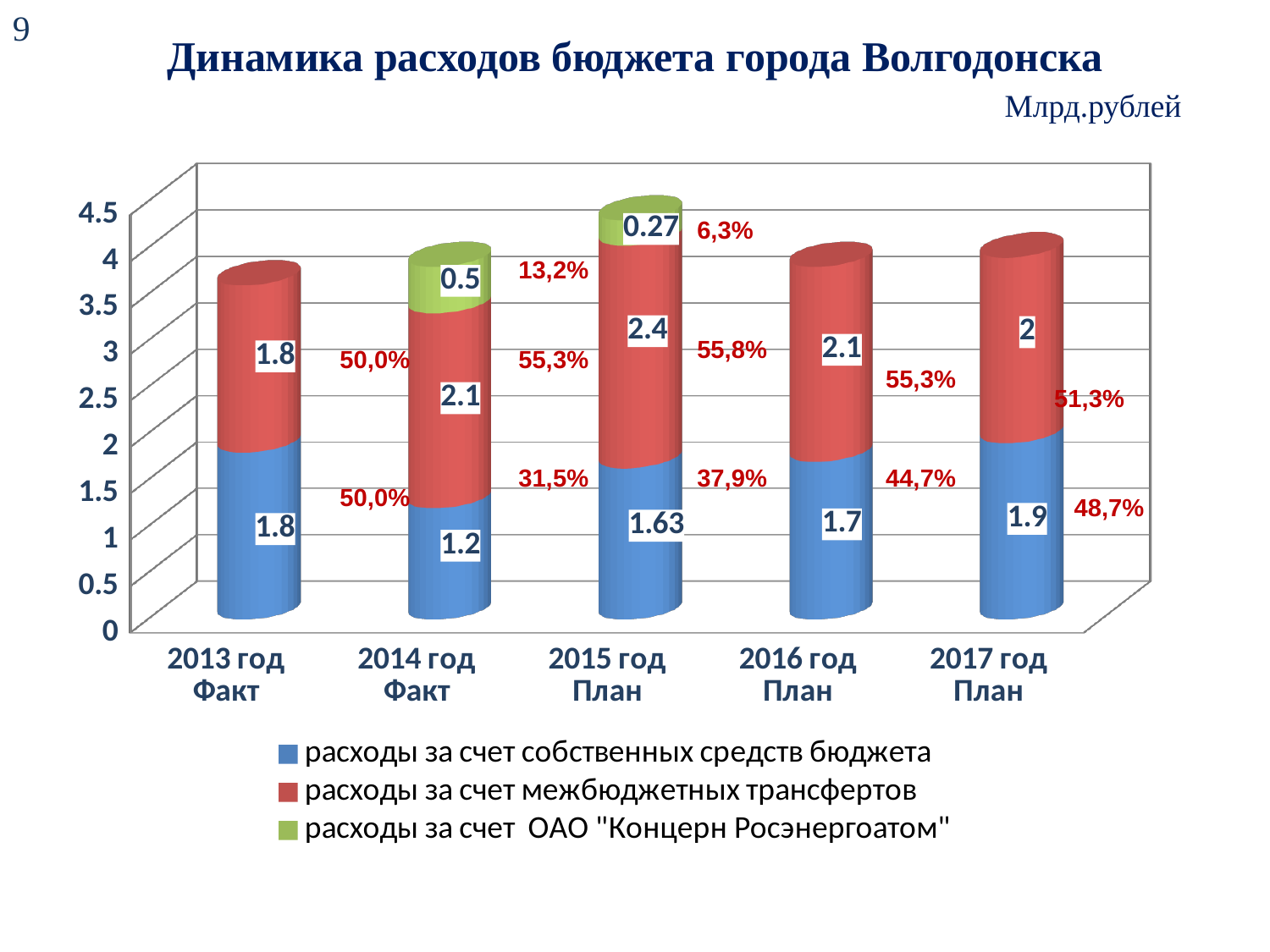
Which year has the lowest value for 'расходы за счет собственных средств бюджета'? 2014 год Факт What is the value of 'расходы за счет собственных средств бюджета' for 2015 год План? 1.63 What is the title of the chart? Динамика расходов бюджета города Волгодонска Which is larger: 'расходы за счет ОАО "Концерн Росэнергоатом"' in 2014 год Факт or in 2015 год План? 2014 год Факт How many categories (years) are shown on the x axis? 5 What is the value of 'расходы за счет межбюджетных трансфертов' for 2014 год Факт? 2.1 What is the total of the stacked bar for 2015 год План? 4.3 What is the difference between 'расходы за счет межбюджетных трансфертов' in 2015 год План and 2013 год Факт? 0.6 How many series does the legend list? 3 Which year has the highest value for 'расходы за счет собственных средств бюджета'? 2017 год План What type of chart is shown on the slide? stacked bar chart What is the value of 'расходы за счет ОАО "Концерн Росэнергоатом"' for 2015 год План? 0.27